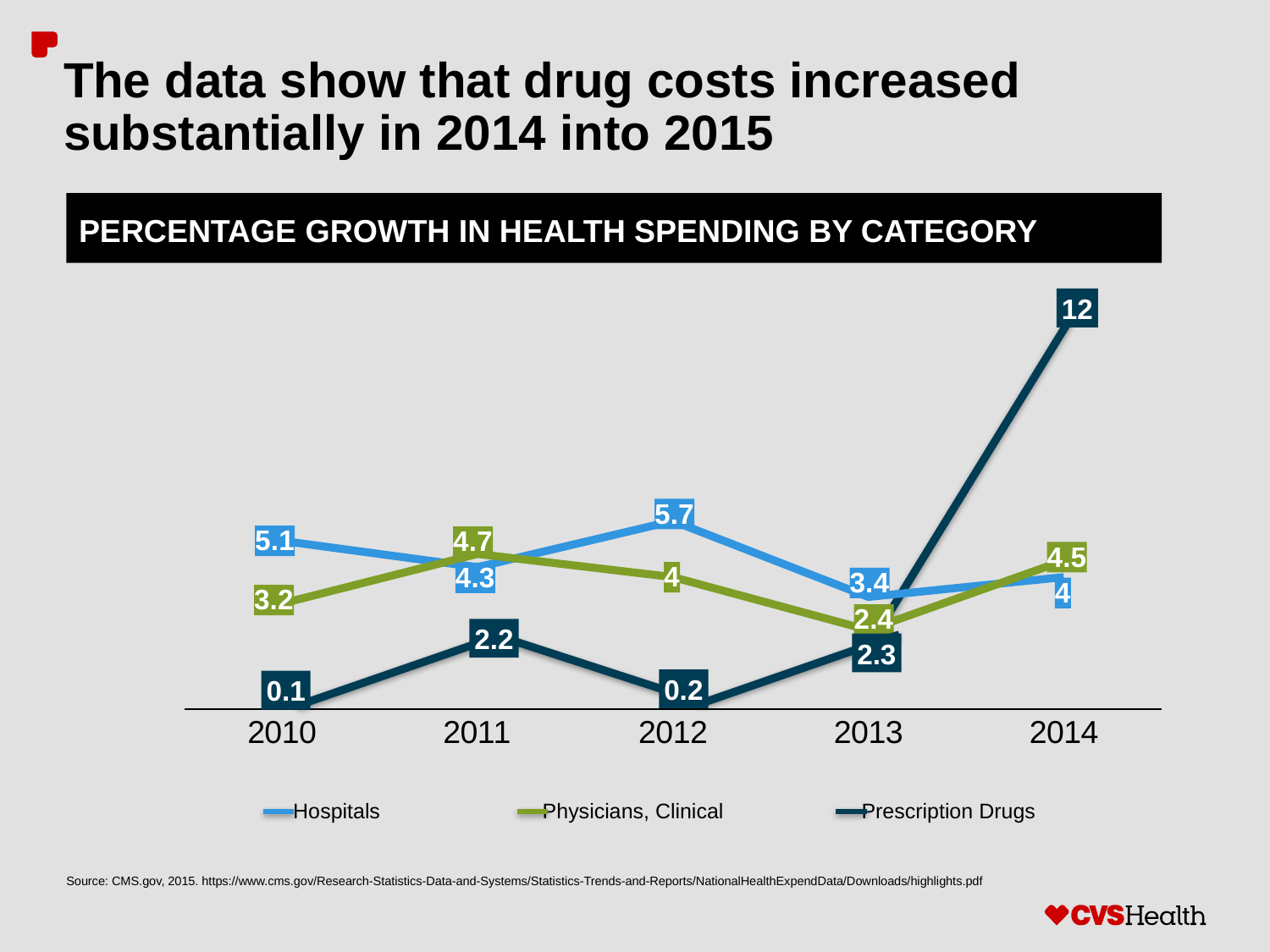
Does the Prescription Drugs value rise or fall from 2013 to 2014? Rise What is the value for Hospitals in 2012? 5.7 Which is larger in 2011: Hospitals or Physicians, Clinical? Physicians, Clinical What is the value for Prescription Drugs in 2014? 12 In which year is the Hospitals value highest? 2012 What is the value for Physicians, Clinical in 2013? 2.4 What type of chart is shown on the slide? Line chart What is the title of the chart? PERCENTAGE GROWTH IN HEALTH SPENDING BY CATEGORY What is the difference between the Prescription Drugs values in 2014 and 2013? 9.7 In which year is the Prescription Drugs value lowest? 2010 How many years are shown on the x axis? 5 How many series does the legend list? 3